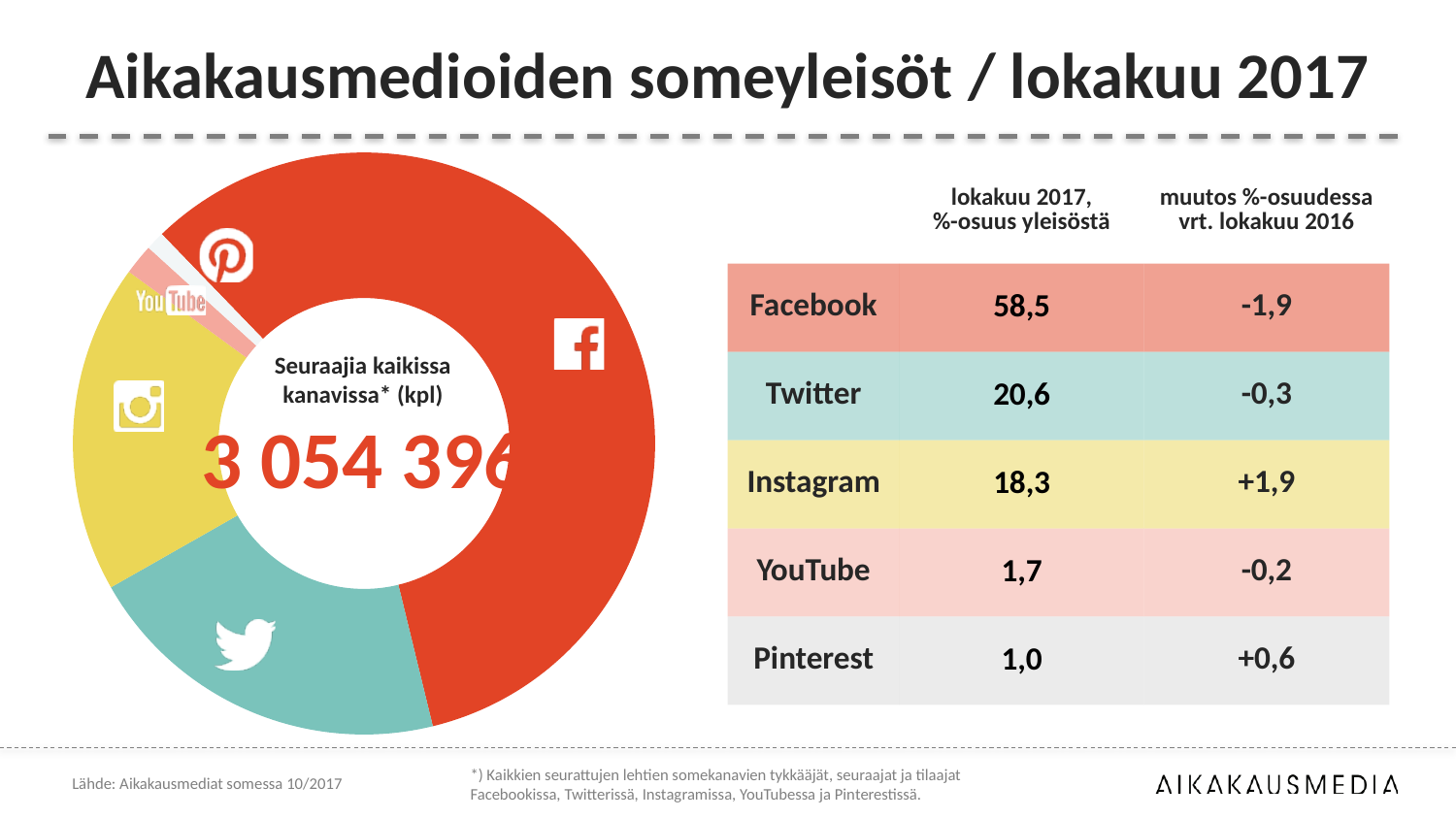
Which channel has the smallest share of the audience in the donut chart? Pinterest Which channel has the largest share of the audience in the donut chart? Facebook What is the difference in percentage share between Twitter (20,6) and Instagram (18,3)? 2,3 What is Facebook's percentage share of the audience in October 2017? 58,5 What is Instagram's percentage share of the audience in October 2017? 18,3 What is the change in percentage share for Facebook compared with October 2016? -1,9 How many social media channels are shown as slices in the donut chart? 5 Which has a larger share of the audience, Twitter or Instagram? Twitter What total number of followers across all channels is printed in the centre of the donut chart? 3 054 396 Is Facebook's share of the audience greater or less than 50? greater What is the change in percentage share for Instagram compared with October 2016? +1,9 What kind of chart is shown on the left of the slide? Donut (pie) chart